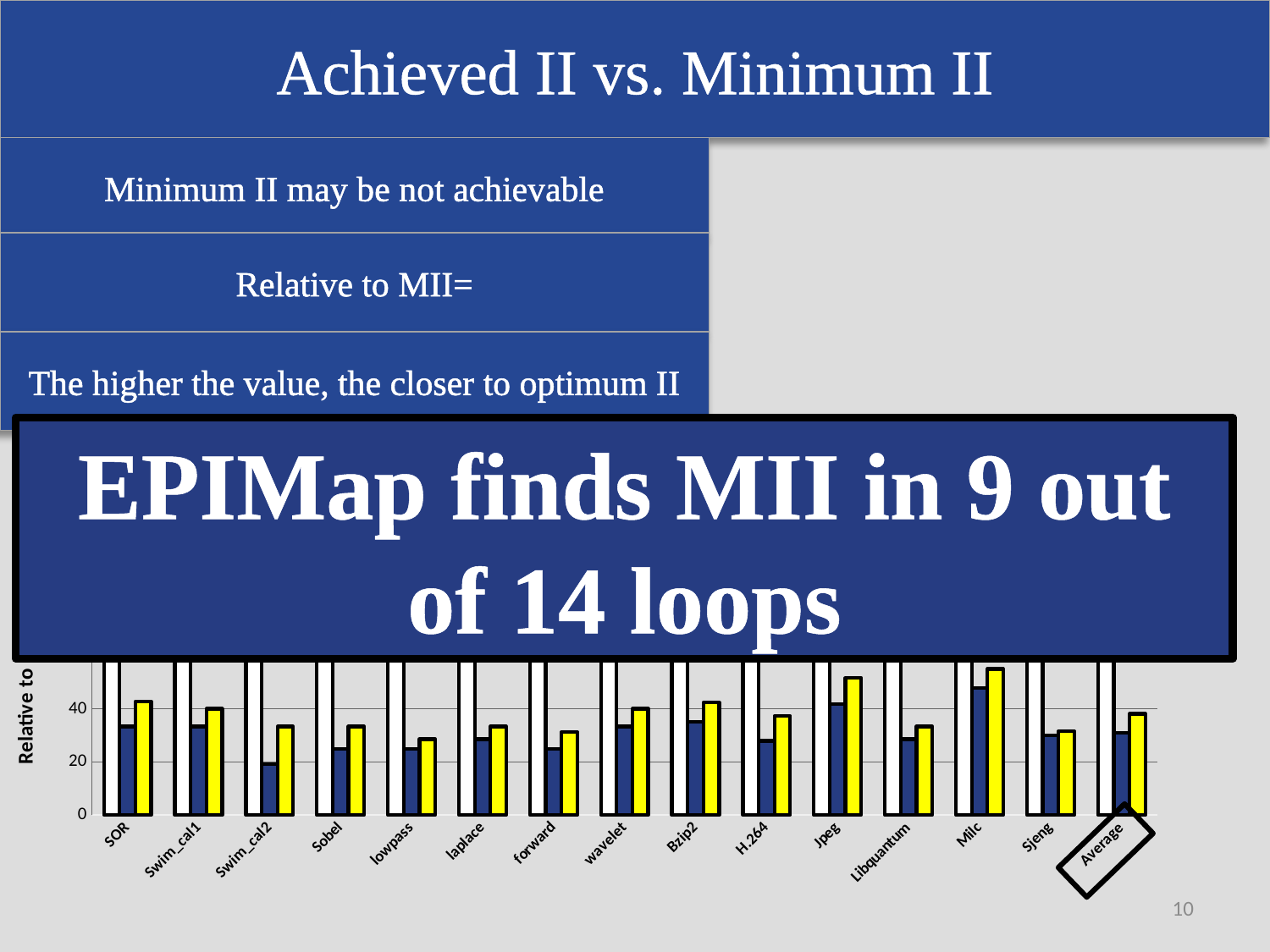
How many categories are shown on the x axis of the chart? 15 Which category has the tallest blue bar in the chart? Milc How many bars are shown for each category in the chart? 3 Is the blue bar for Milc greater or less than 40? greater Which category has the shortest blue bar in the chart? Swim_cal2 Is the yellow bar for Jpeg greater or less than 40? greater What kind of chart is shown at the bottom of the slide? bar chart Which is larger, the yellow bar for Jpeg or the yellow bar for Sobel? Jpeg Is the blue bar for Sobel greater or less than 40? less Which x-axis category label is outlined with a box on the chart? Average Which is larger, the blue bar for SOR or the blue bar for Swim_cal2? SOR